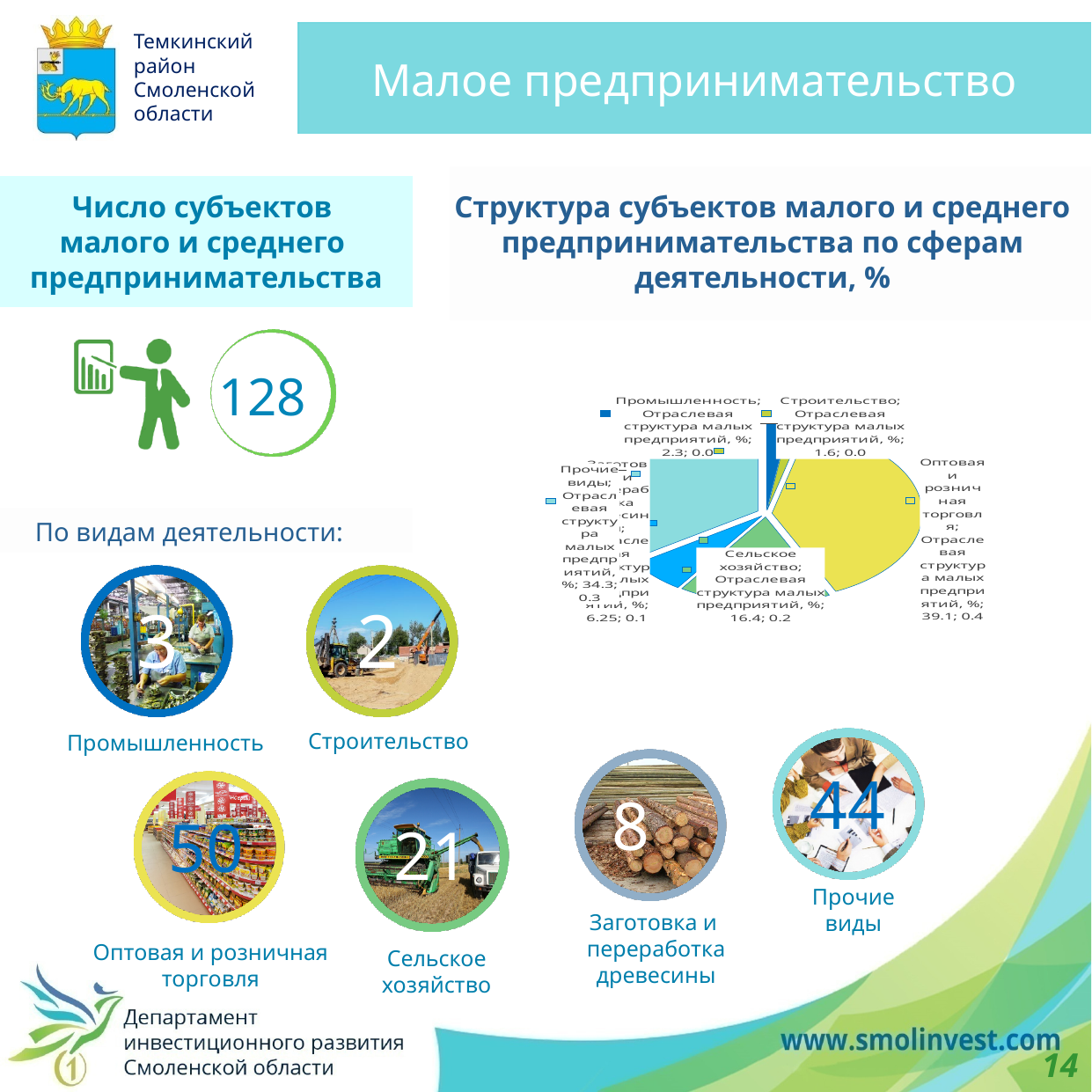
What is the difference between the values for Оптовая и розничная торговля and Прочие виды in the pie chart? 4.8 What is the value shown for Прочие виды in the pie chart? 34.3 What kind of chart is shown on the slide? Pie chart What is the value shown for Сельское хозяйство in the pie chart? 16.4 What is the title of the pie chart on the slide? Структура субъектов малого и среднего предпринимательства по сферам деятельности, % What is the value shown for Оптовая и розничная торговля in the pie chart? 39.1 What is the value shown for Строительство in the pie chart? 1.6 Which category has the smallest slice in the pie chart? Строительство How many slices does the pie chart have? 6 What is the value shown for Промышленность in the pie chart? 2.3 Which category has the largest slice in the pie chart? Оптовая и розничная торговля Which is larger in the pie chart: Сельское хозяйство or Прочие виды? Прочие виды